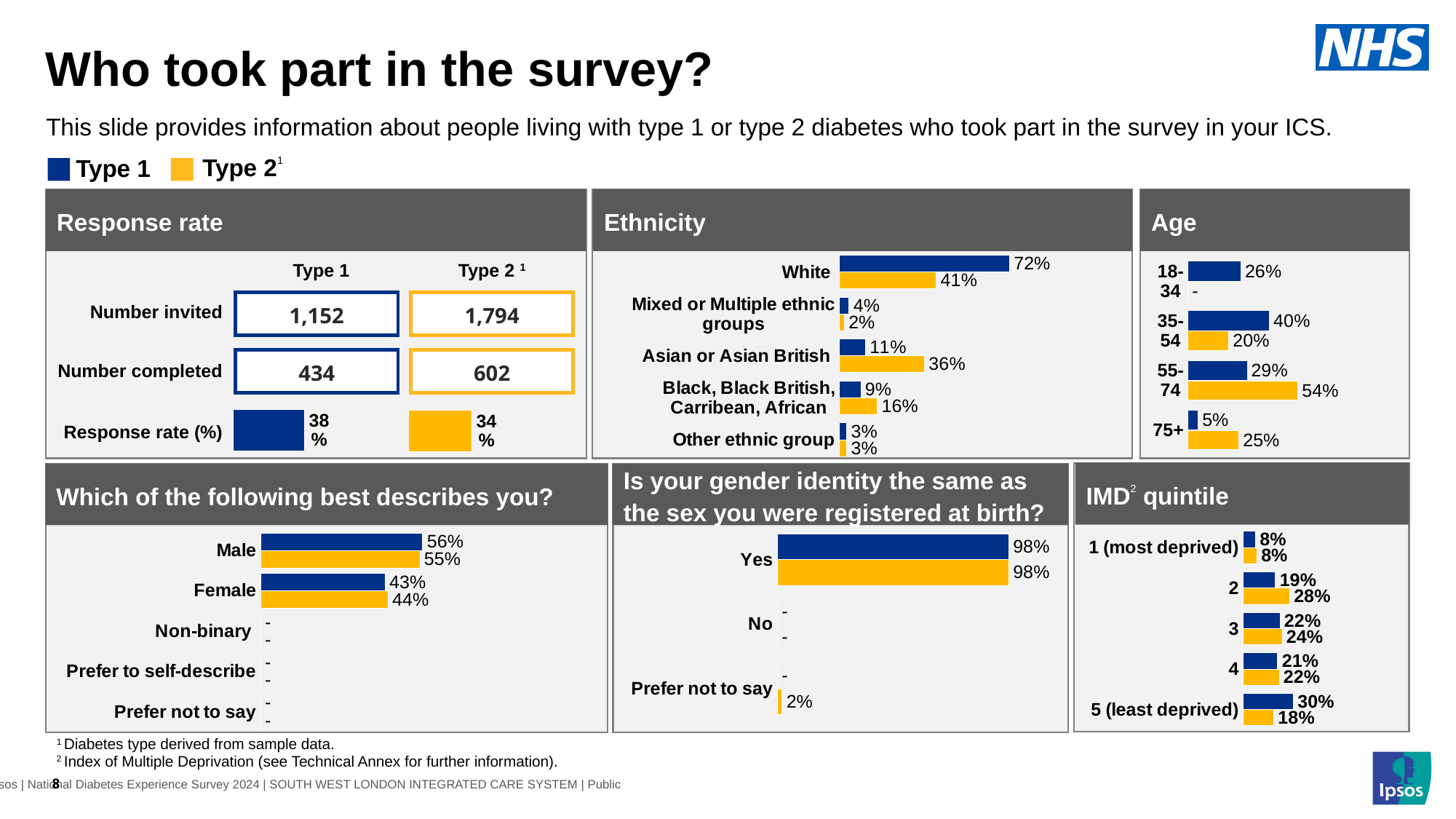
In the Ethnicity chart, what is the Type 2 value for Asian or Asian British? 36% In the gender identity chart, what is the Type 2 value for Prefer not to say? 2% In the Ethnicity chart, what is the Type 1 value for White? 72% In the Age chart, which age group has the highest Type 2 value? 55-74 What type of chart is the Age chart? Bar chart In the Age chart, what is the difference between the Type 2 and Type 1 values for 75+? 20% How many ethnic group categories are shown in the Ethnicity chart? 5 In the IMD quintile chart, what is the difference between the Type 1 and Type 2 values for 5 (least deprived)? 12% In the Age chart, which age group has the lowest Type 1 value? 75+ In the IMD quintile chart, which quintile has the highest Type 1 value? 5 (least deprived) In the 'Which of the following best describes you?' chart, what is the Type 2 value for Female? 44% In the IMD quintile chart, is the Type 1 or Type 2 value larger for quintile 2? Type 2